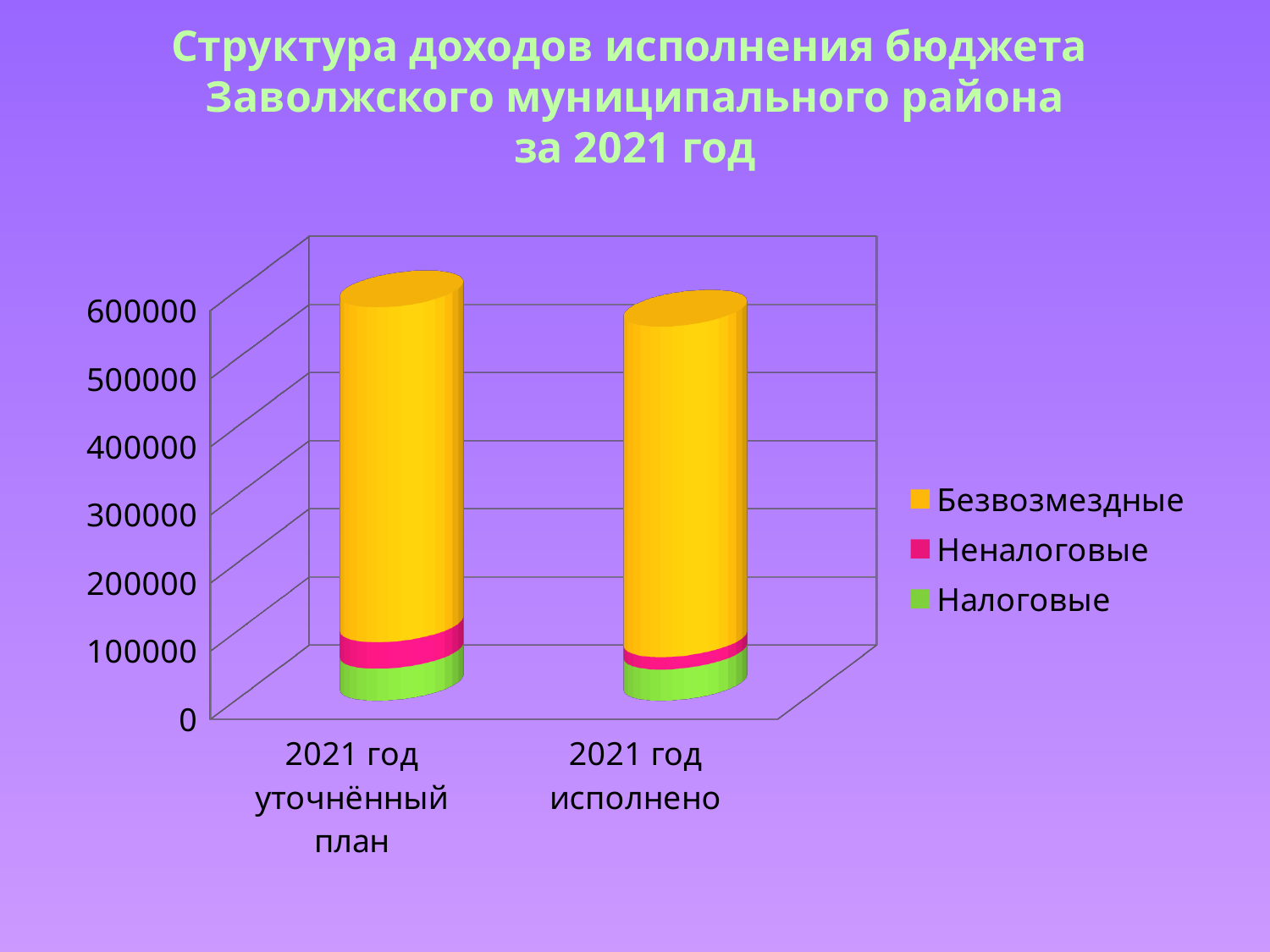
Which series makes up the largest part of the bar for "2021 год уточнённый план"? Безвозмездные How many series does the legend list? 3 Do the bar totals rise or fall from "2021 год уточнённый план" to "2021 год исполнено"? fall Is the value of "Налоговые" for "2021 год уточнённый план" greater or less than 200000? less Which bar has the larger total: "2021 год уточнённый план" or "2021 год исполнено"? 2021 год уточнённый план Which series makes up the smallest part of the bar for "2021 год исполнено"? Неналоговые How many categories are shown on the x axis of the chart? 2 What is the title of the chart on the slide? Структура доходов исполнения бюджета Заволжского муниципального района за 2021 год What kind of chart is shown on the slide? Bar chart Is the total for "2021 год исполнено" greater or less than 500000? greater What colour represents the "Налоговые" series in the chart? Green